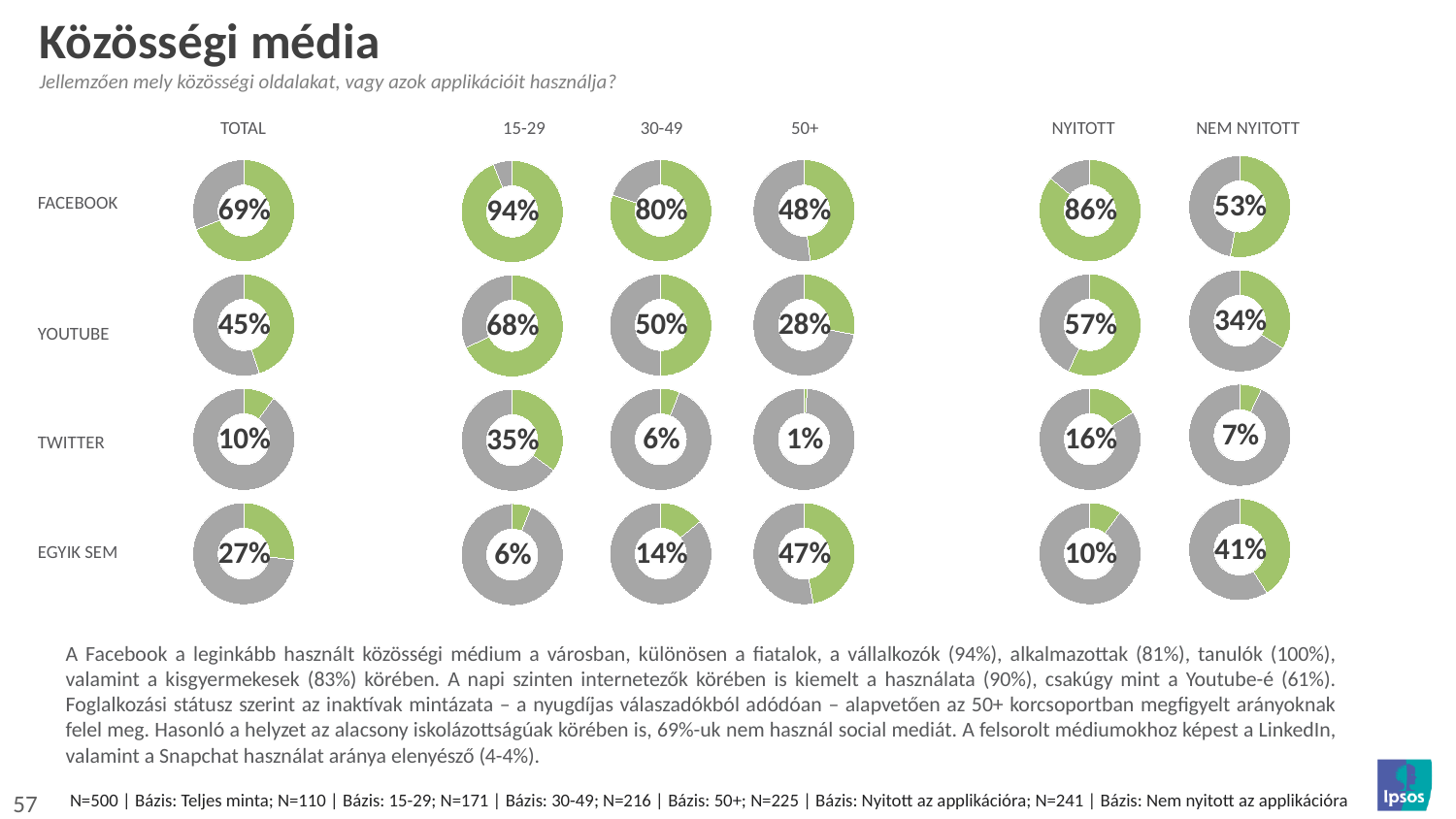
How many donut charts are shown in the EGYIK SEM row? 6 In the 50+ column, what percentage is shown in the TWITTER donut chart? 1% In the TOTAL column, what percentage is shown in the FACEBOOK donut chart? 69% Across the age-group columns 15-29, 30-49 and 50+, does the YOUTUBE percentage rise or fall with increasing age? Fall What is the difference between the FACEBOOK percentages in the NYITOTT and NEM NYITOTT donut charts? 33% Across the FACEBOOK row of donut charts, which column shows the highest percentage? 15-29 In the 15-29 column, what percentage is shown in the YOUTUBE donut chart? 68% Across the TWITTER row of donut charts, which column shows the lowest percentage? 50+ In the NEM NYITOTT column, what percentage is shown in the EGYIK SEM donut chart? 41% What type of chart is used to display the percentages on this slide? Donut (pie) chart What is the difference between the EGYIK SEM percentages in the 50+ and 15-29 donut charts? 41% In the 30-49 column, which donut chart shows a larger percentage: FACEBOOK or YOUTUBE? FACEBOOK